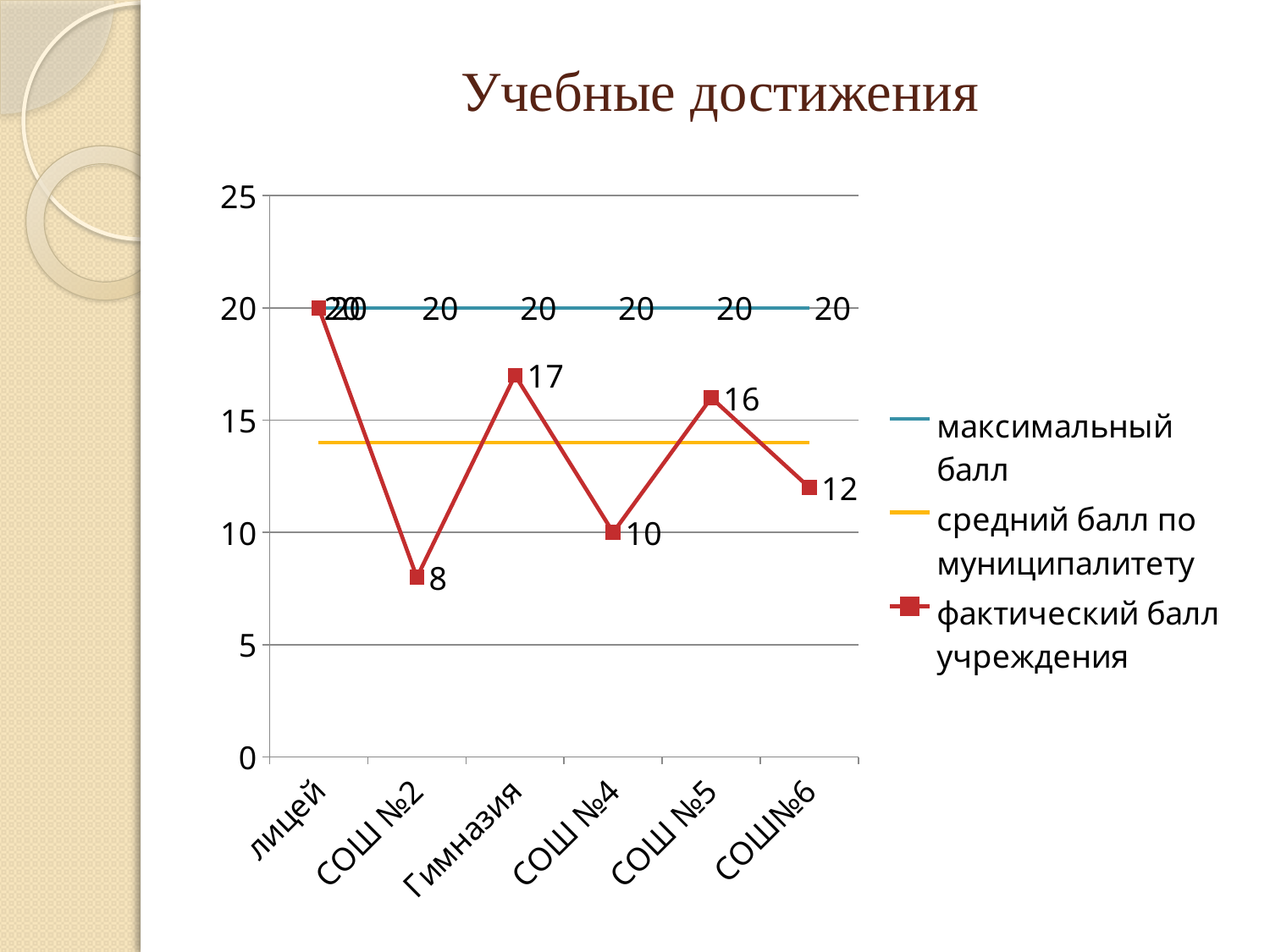
What is the difference between the фактический балл учреждения for СОШ №5 and СОШ №4? 6 Is the value of средний балл по муниципалитету greater or less than 15? less How many series does the legend list? 3 How many categories are shown on the x axis? 6 Which category has the highest фактический балл учреждения? лицей What is the title of the chart? Учебные достижения What is the фактический балл учреждения for Гимназия? 17 What is the фактический балл учреждения for СОШ №2? 8 What is the максимальный балл for СОШ №4? 20 What type of chart is shown on the slide? line chart Which is larger, the фактический балл учреждения for Гимназия or for СОШ№6? Гимназия Which category has the lowest фактический балл учреждения? СОШ №2